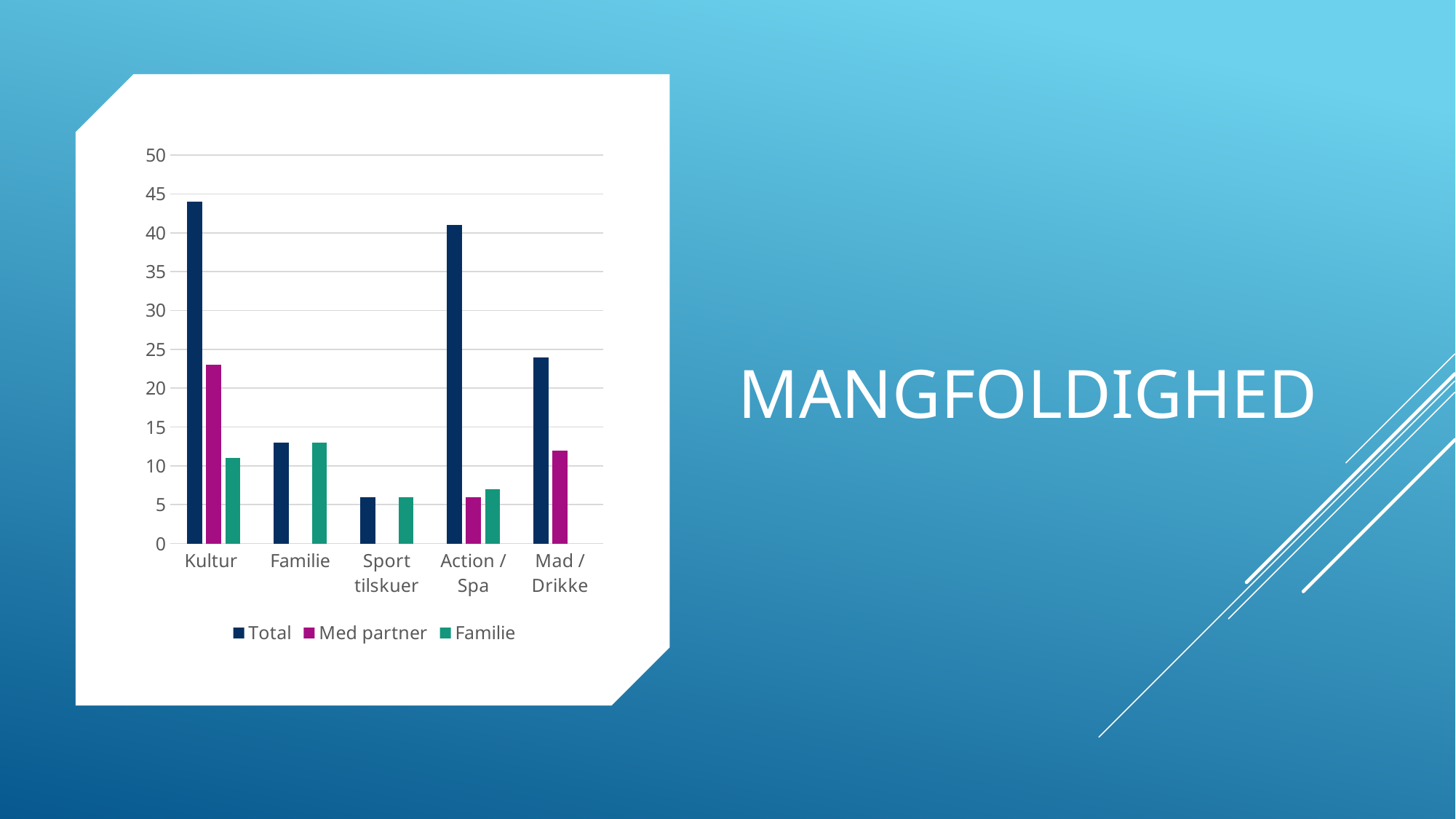
Which category has the lowest Total value? Sport tilskuer Which is larger, the Total value for Mad / Drikke or the Total value for Familie? Mad / Drikke Which category has the highest Med partner value? Kultur Is the Total value for Sport tilskuer greater or less than 10? less Which category has the highest Total value? Kultur How many series does the chart legend list? 3 Is the Med partner value for Kultur greater or less than 20? greater Is the Total value for Kultur greater or less than 40? greater Which series is shown in green in the chart legend? Familie What kind of chart is shown on the slide? Bar chart Which is larger, the Total value for Kultur or the Total value for Action / Spa? Kultur How many categories are shown on the x axis of the chart? 5